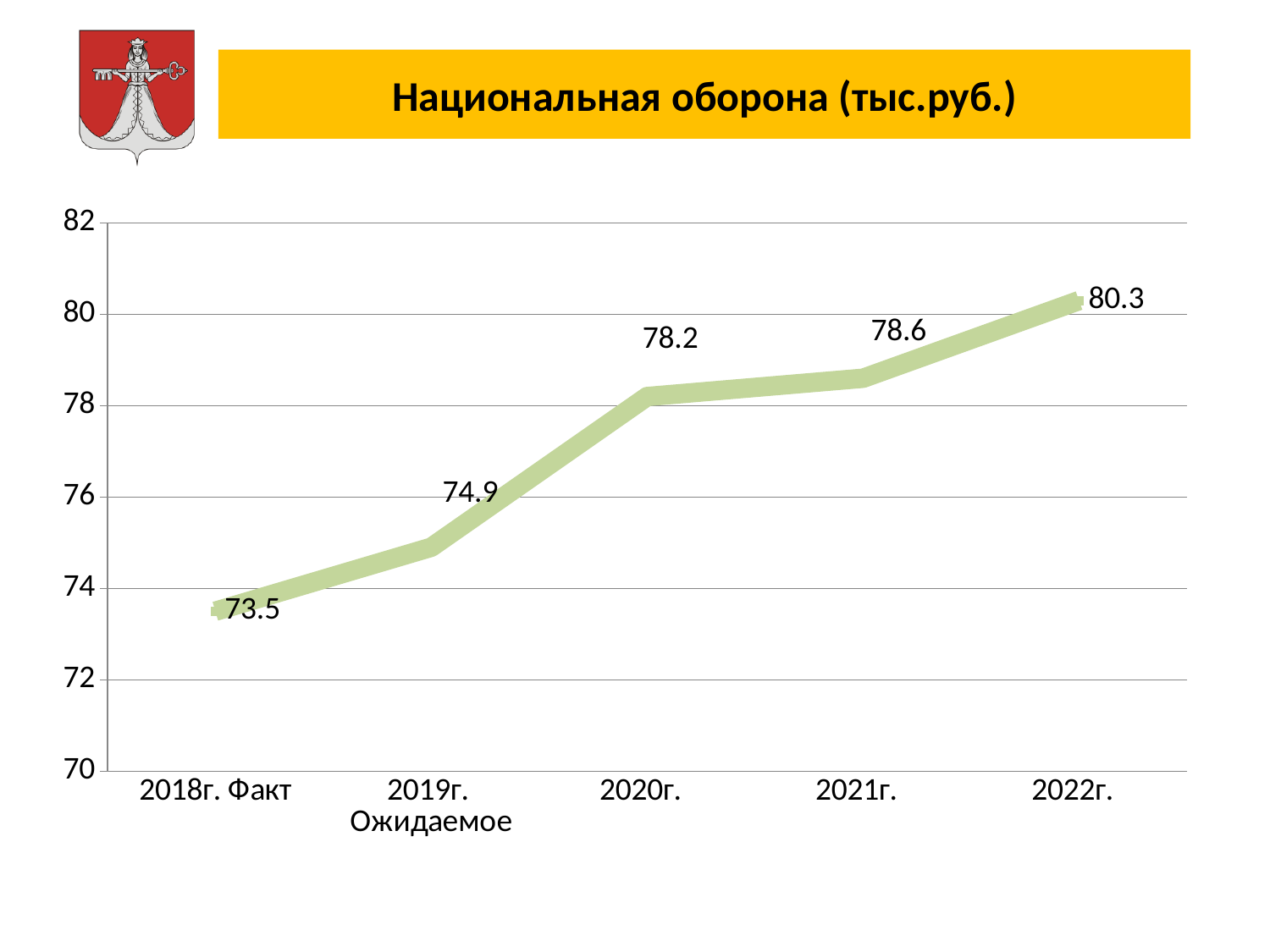
Is the value for 2019г. Ожидаемое greater or less than 76? less What is the value for 2022г.? 80.3 Which is larger, the value for 2021г. or the value for 2020г.? 2021г. Which category has the lowest value? 2018г. Факт What is the value for 2018г. Факт? 73.5 How many data points are plotted on the chart? 5 What kind of chart is shown on the slide? line chart Which year has the highest value? 2022г. What is the value for 2020г.? 78.2 What is the value for 2019г. Ожидаемое? 74.9 What is the difference between the values for 2022г. and 2018г. Факт? 6.8 Do the values rise or fall from 2018г. Факт to 2022г.? rise